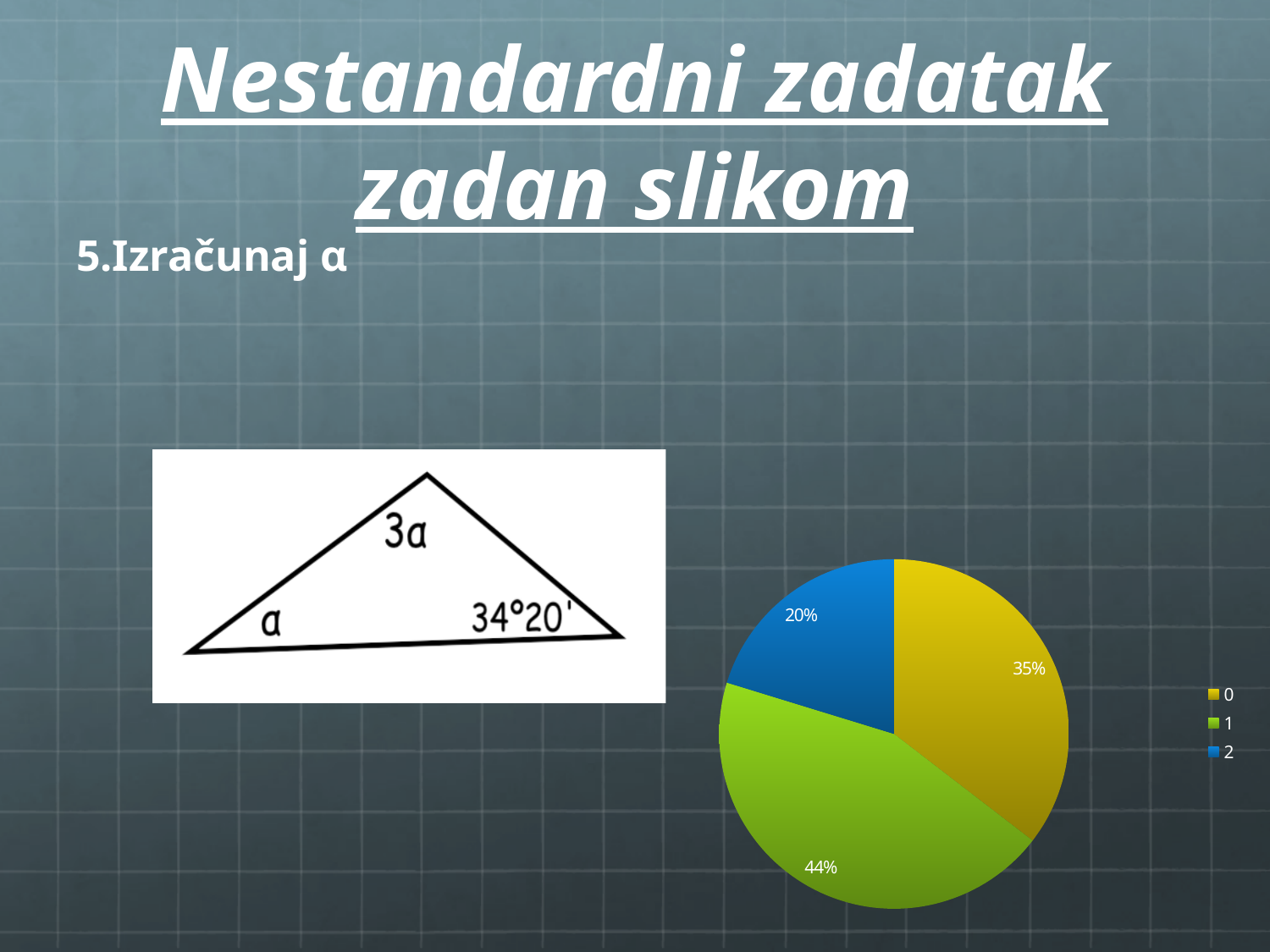
Which category has the largest slice of the pie? 1 What colour is the slice for category 2? blue What colour is the slice for category 0? yellow Which slice is larger, category 0 or category 2? 0 How many slices does the pie chart have? 3 What kind of chart is shown on the slide? pie chart What is the difference in percentage points between the slices for category 1 and category 0? 9 Which category has the smallest slice of the pie? 2 What is the share of the pie for category 0? 35% What is the share of the pie for category 2? 20% How many entries does the legend list? 3 What is the share of the pie for category 1? 44%